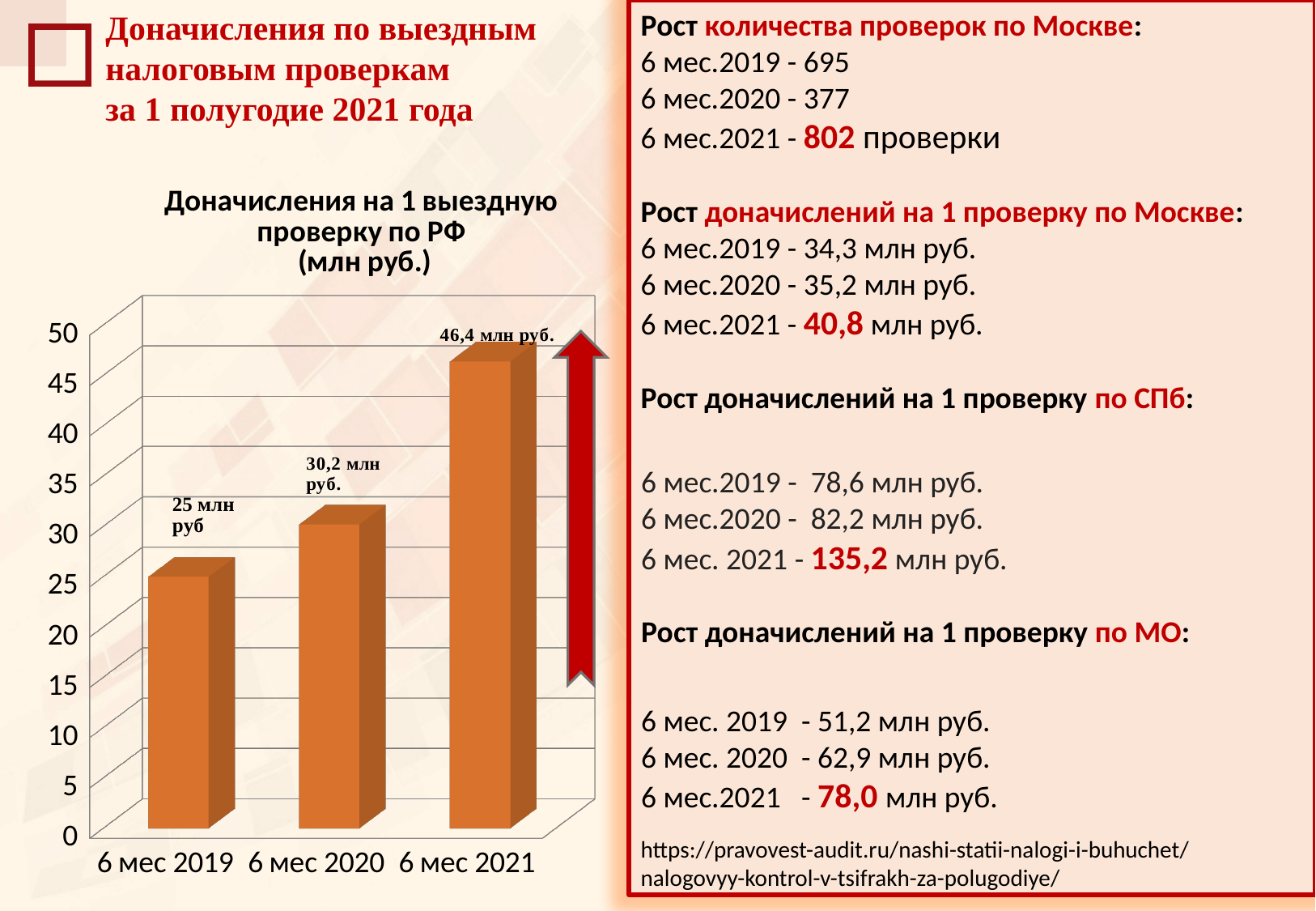
What is the value for 6 мес 2021 in the chart? 46,4 млн руб. Do the values rise or fall from 6 мес 2019 to 6 мес 2021 along the x axis? rise Which category has the lowest value in the chart? 6 мес 2019 What is the value for 6 мес 2019 in the chart? 25 млн руб Which is larger, the value for 6 мес 2020 or the value for 6 мес 2019? 6 мес 2020 What is the value for 6 мес 2020 in the chart? 30,2 млн руб. What is the difference between the values for 6 мес 2021 and 6 мес 2020? 16,2 млн руб. How many categories are plotted in the chart? 3 What is the difference between the values for 6 мес 2021 and 6 мес 2019? 21,4 млн руб. What type of chart is shown on the slide? bar chart What is the title of the chart? Доначисления на 1 выездную проверку по РФ (млн руб.) Which category has the highest value in the chart? 6 мес 2021